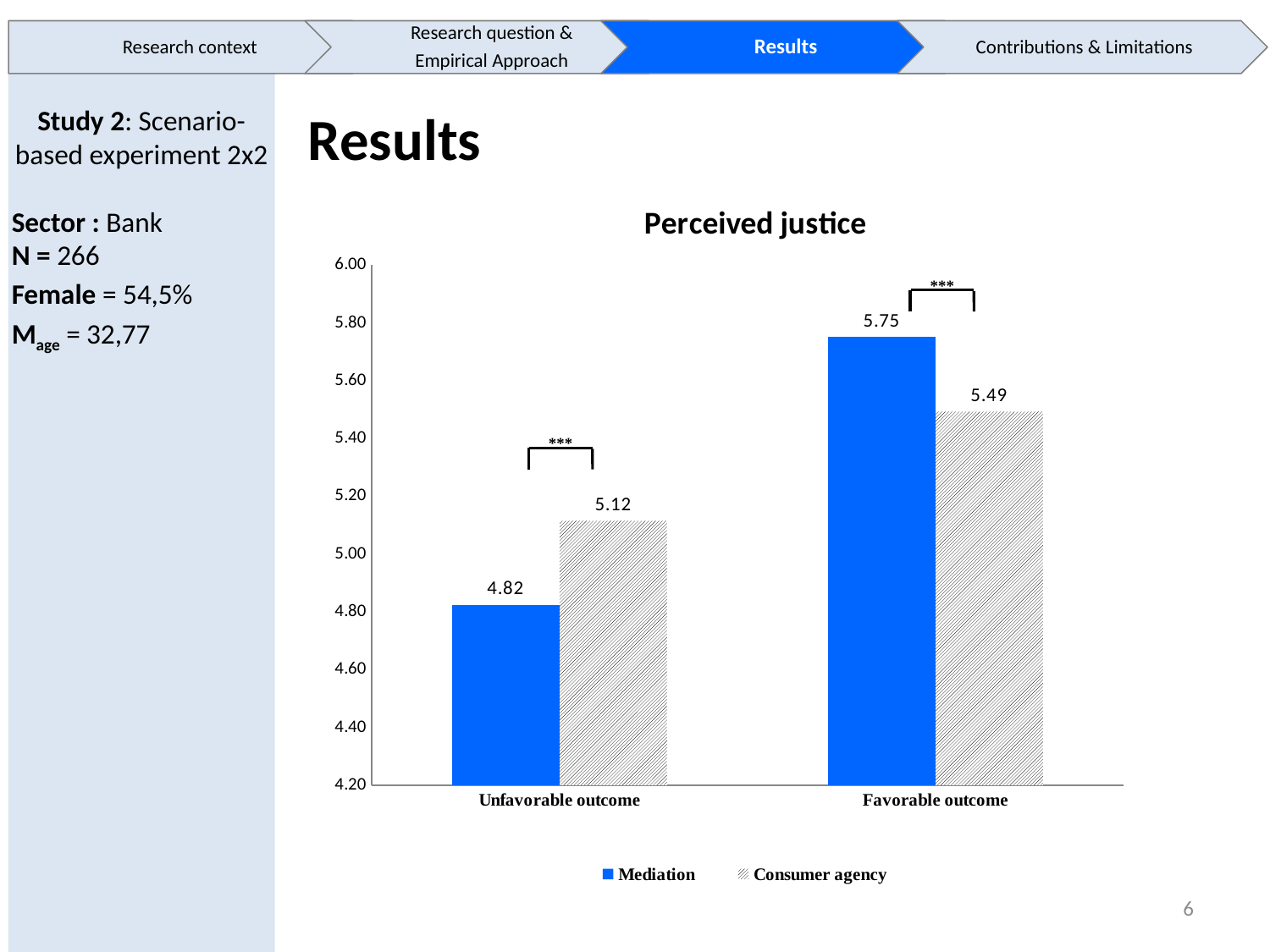
What is the title of the chart? Perceived justice What is the difference between the Consumer agency and Mediation values for Unfavorable outcome? 0.30 What kind of chart is shown on the slide? Bar chart What is the Consumer agency value for Unfavorable outcome? 5.12 What is the Mediation value for Favorable outcome? 5.75 How many series does the legend list? 2 Which bar has the lowest value in the chart? Mediation, Unfavorable outcome What is the Mediation value for Unfavorable outcome? 4.82 What is the Consumer agency value for Favorable outcome? 5.49 What is the difference between the Mediation and Consumer agency values for Favorable outcome? 0.26 Which bar has the highest value in the chart? Mediation, Favorable outcome For Unfavorable outcome, which is larger: Mediation or Consumer agency? Consumer agency